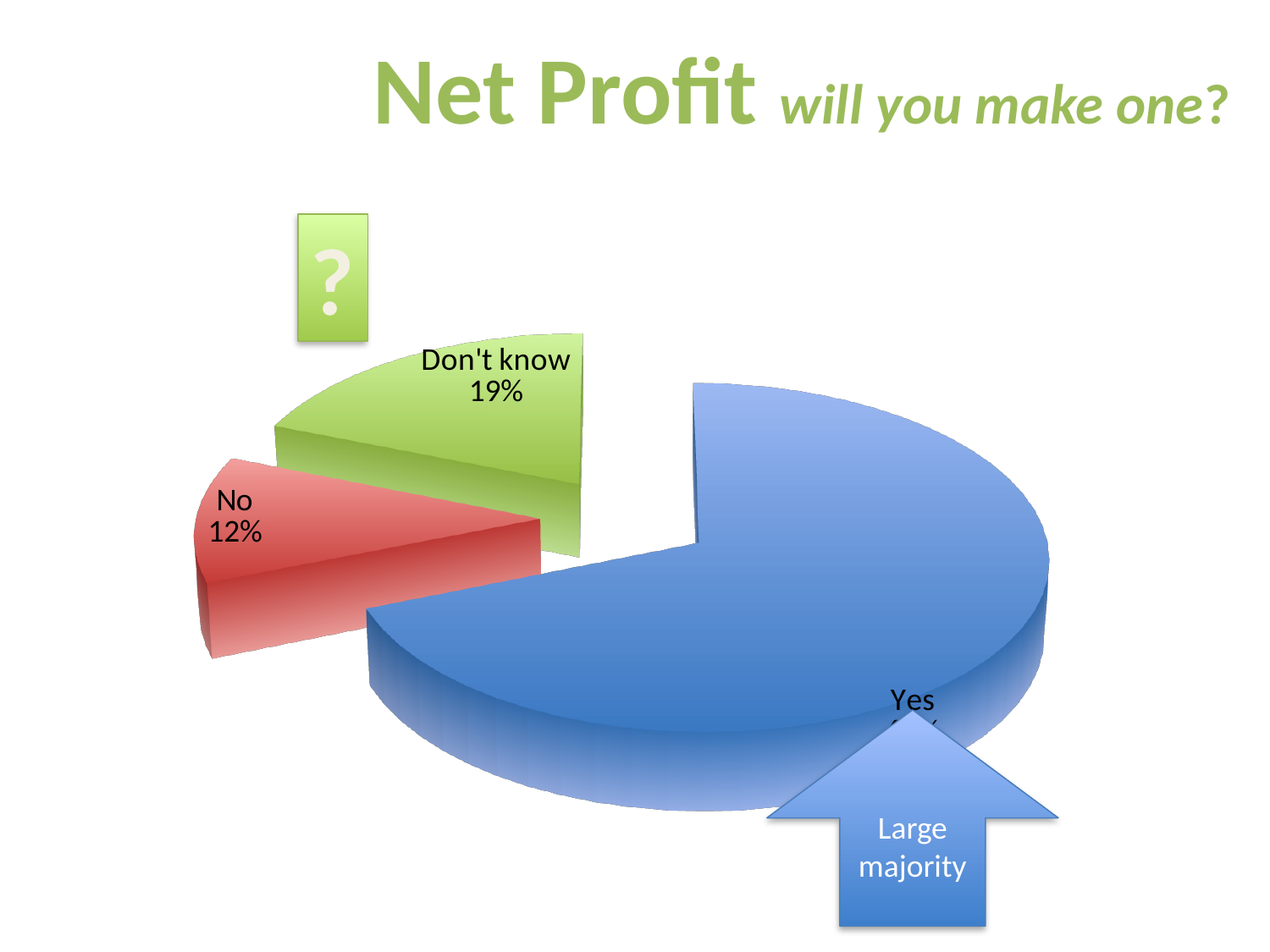
Which slice is larger, "Don't know" or "No"? Don't know By how many percentage points does "Don't know" exceed "No"? 7 percentage points What percentage of respondents answered "Don't know"? 19% What kind of chart is shown on the slide? Pie chart What percentage of respondents answered "No"? 12% How many slices does the pie chart have? 3 Which response has the smallest slice of the pie? No What colour is the "Yes" slice? Blue What is the title of the slide? Net Profit will you make one? Which response has the largest slice of the pie? Yes